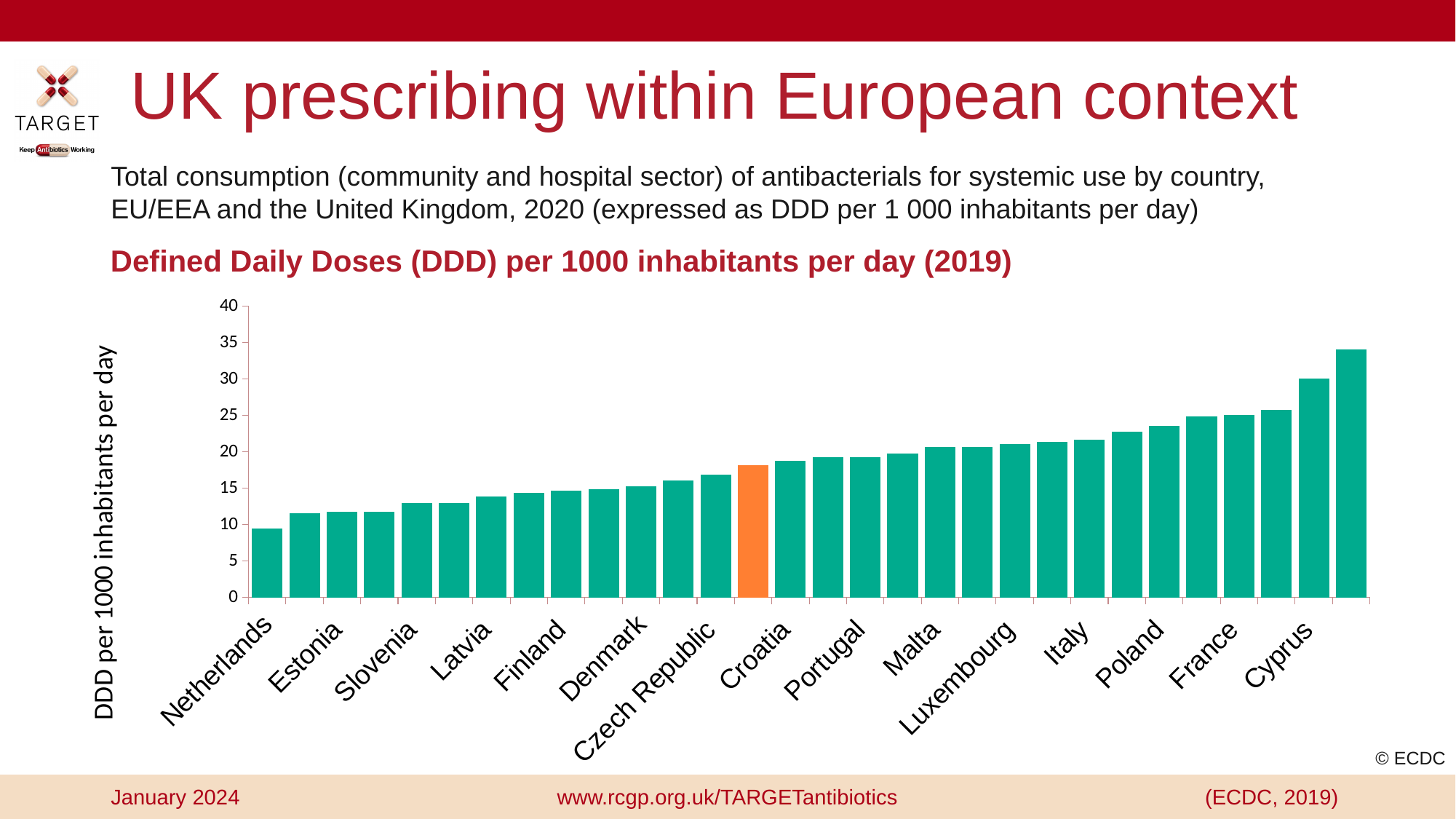
Is the value for Estonia greater or less than 10? greater Do the bar values rise or fall from left to right along the x axis? rise What colour is the single highlighted bar that differs from the others? orange What kind of chart is shown on the slide? bar chart Is the value for Netherlands greater or less than 10? less How many country labels are shown on the x axis? 15 Is the value for Poland greater or less than 20? greater Which has a higher value, Poland or Estonia? Poland Which labelled country has the lowest DDD per 1000 inhabitants per day? Netherlands